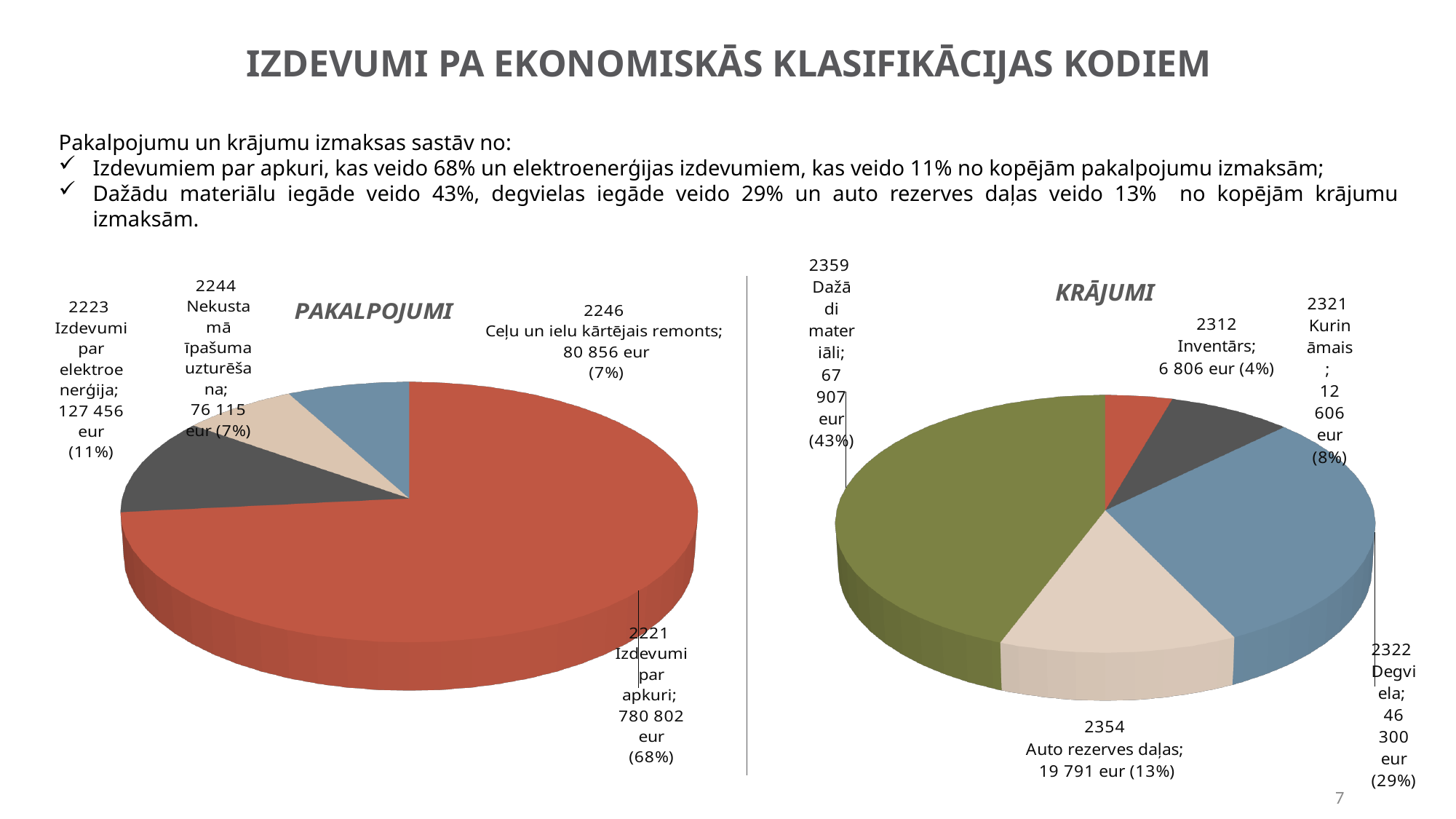
In the PAKALPOJUMI chart, what is the value for 2221 Izdevumi par apkuri? 780 802 eur In the KRĀJUMI chart, what share of the pie is 2359 Dažādi materiāli? 43% In the KRĀJUMI chart, what is the value for 2322 Degviela? 46 300 eur In the PAKALPOJUMI chart, what is the difference in eur between 2246 Ceļu un ielu kārtējais remonts and 2244 Nekustamā īpašuma uzturēšana? 4 741 eur In the PAKALPOJUMI chart, what share of the pie is 2223 Izdevumi par elektroenerģija? 11% In the KRĀJUMI chart, how many slices does the pie have? 5 What type of chart is the PAKALPOJUMI chart? pie chart In the PAKALPOJUMI chart, how many slices does the pie have? 4 In the KRĀJUMI chart, which category has the smallest slice? 2312 Inventārs In the PAKALPOJUMI chart, which category has the largest slice? 2221 Izdevumi par apkuri What is the title of the chart on the right side of the slide? KRĀJUMI In the KRĀJUMI chart, which is larger: 2354 Auto rezerves daļas or 2321 Kurināmais? 2354 Auto rezerves daļas